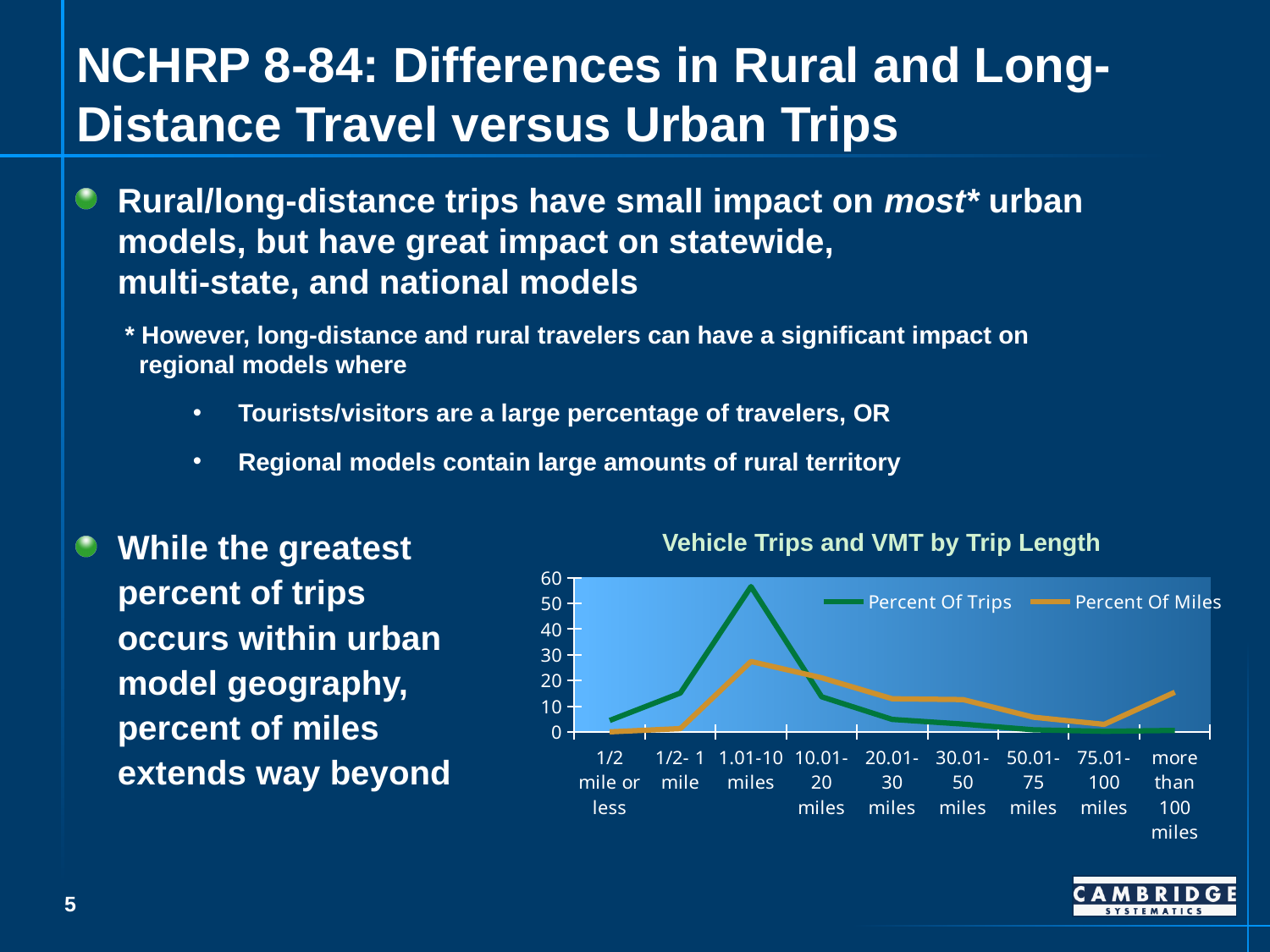
Which colour is used for the Percent Of Miles line? Orange What is the title of the chart? Vehicle Trips and VMT by Trip Length For the 1.01-10 miles category, which is larger: Percent Of Trips or Percent Of Miles? Percent Of Trips Is the Percent Of Miles for more than 100 miles greater or less than 10? greater For the 'more than 100 miles' category, which is larger: Percent Of Trips or Percent Of Miles? Percent Of Miles What kind of chart is shown on the slide? Line chart How many series does the chart's legend list? 2 Which trip-length category has the highest Percent Of Trips? 1.01-10 miles Is the Percent Of Miles for 1.01-10 miles greater or less than 30? less How many trip-length categories are shown on the x axis? 9 Is the Percent Of Trips for 1.01-10 miles greater or less than 50? greater Which trip-length category has the highest Percent Of Miles? 1.01-10 miles